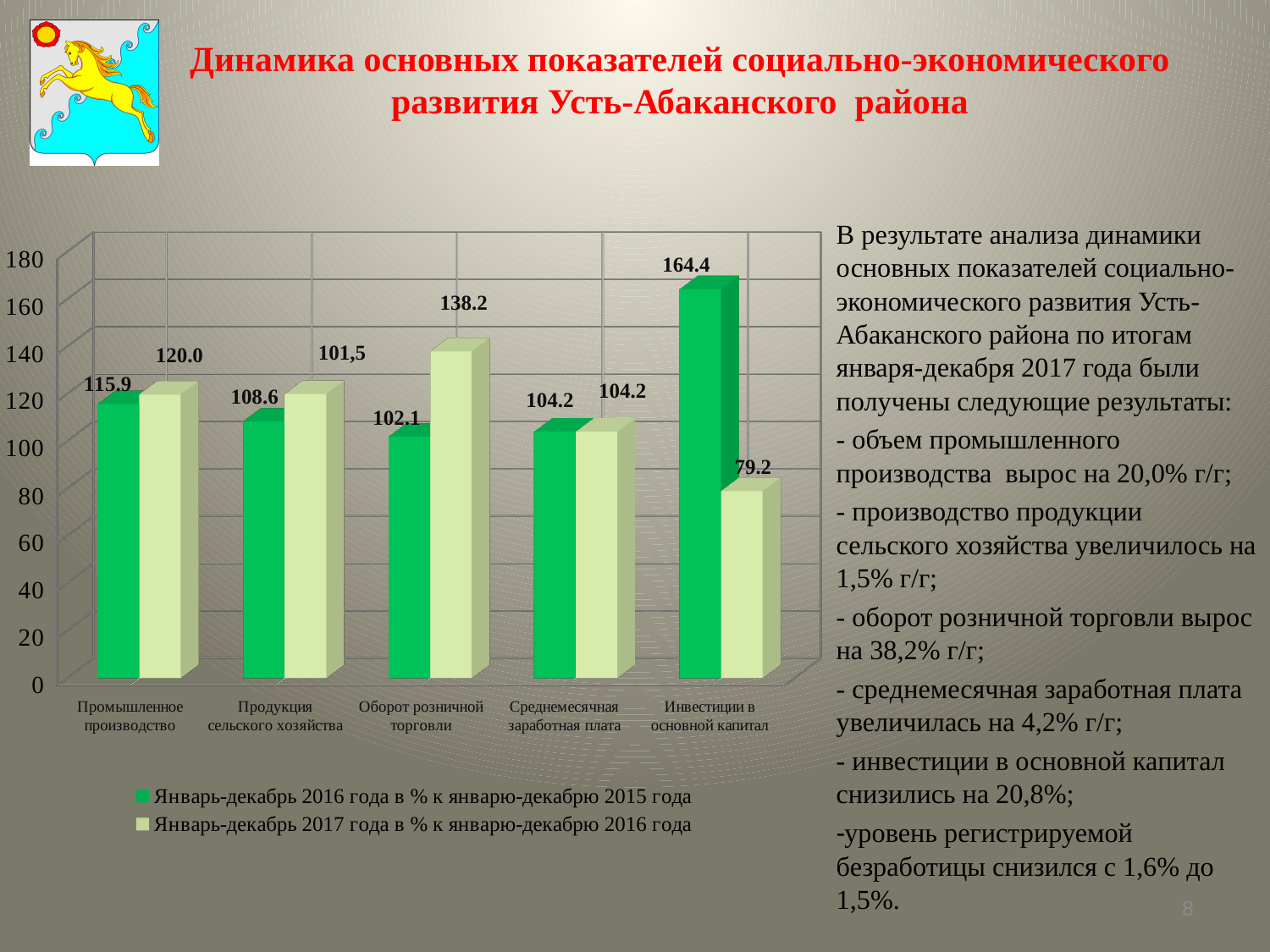
What is the value for Продукция сельского хозяйства in the series 'Январь-декабрь 2017 года в % к январю-декабрю 2016 года'? 101,5 How many series does the chart legend list? 2 For Оборот розничной торговли, which series has the larger value: 2016 or 2017? Январь-декабрь 2017 года в % к январю-декабрю 2016 года What is the value for Оборот розничной торговли in the series 'Январь-декабрь 2017 года в % к январю-декабрю 2016 года'? 138.2 How many categories are shown on the x axis of the chart? 5 What is the value for Инвестиции в основной капитал in the series 'Январь-декабрь 2016 года в % к январю-декабрю 2015 года'? 164.4 Is the 2017 value for Инвестиции в основной капитал greater or less than 100? less What type of chart is shown on the slide? Bar chart Which category has the lowest value in the series 'Январь-декабрь 2017 года в % к январю-декабрю 2016 года'? Инвестиции в основной капитал What is the value for Промышленное производство in the series 'Январь-декабрь 2017 года в % к январю-декабрю 2016 года'? 120.0 Which category has the highest value in the series 'Январь-декабрь 2016 года в % к январю-декабрю 2015 года'? Инвестиции в основной капитал What is the difference between the 2016 and 2017 values for Инвестиции в основной капитал? 85.2